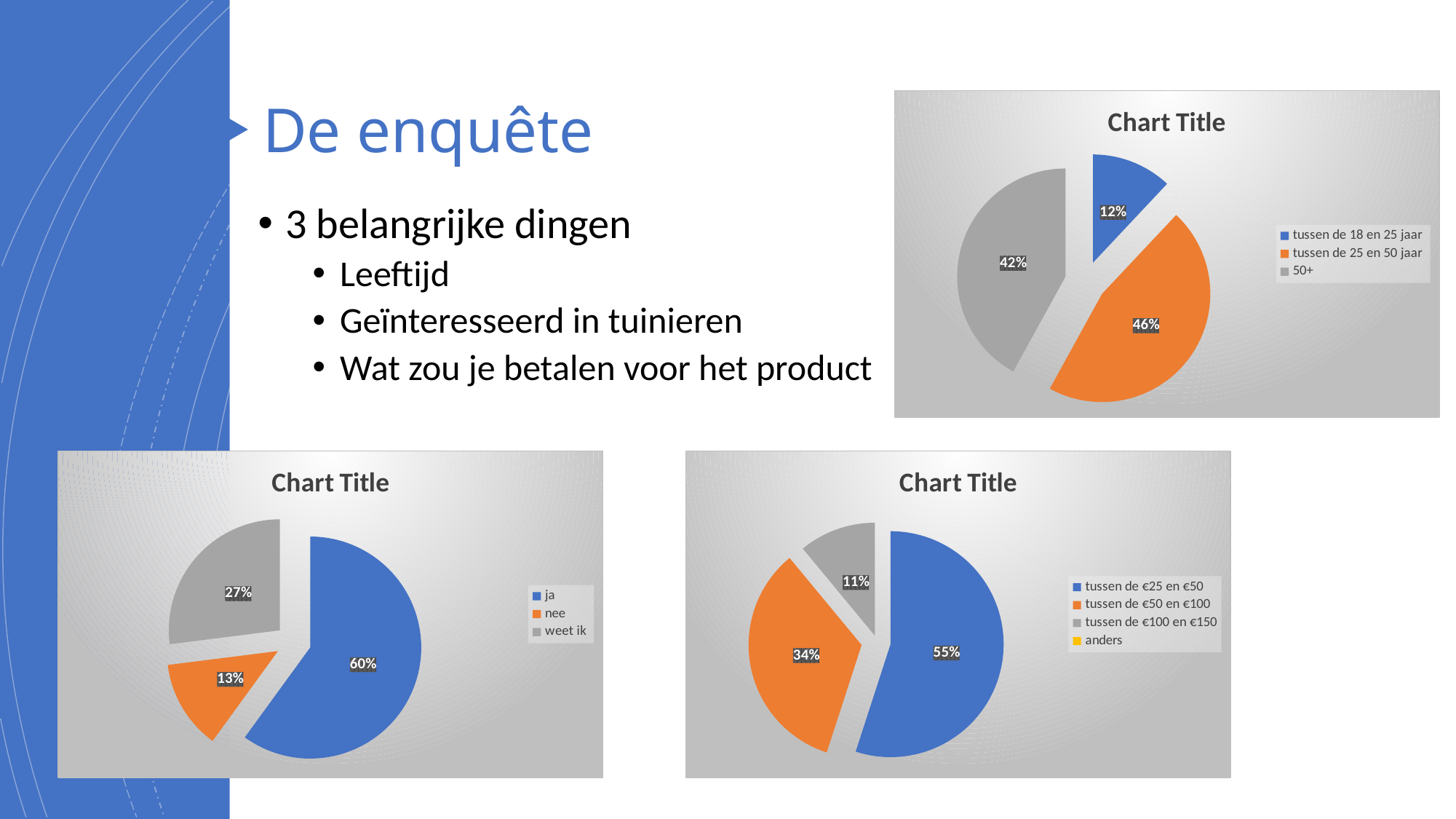
In the bottom-left pie chart, what share is labelled for 'ja'? 60% In the top-right pie chart, what is the difference between the '50+' slice and the 'tussen de 18 en 25 jaar' slice? 30% What type of chart is the bottom-left chart? pie chart In the bottom-left pie chart, which category has the largest slice? ja In the top-right pie chart, how many legend entries are listed? 3 In the bottom-left pie chart, what is the difference between the 'weet ik' slice and the 'nee' slice? 14% In the bottom-right pie chart, how many entries does the legend list? 4 In the bottom-right pie chart, what share is labelled for 'tussen de €50 en €100'? 34% In the bottom-right pie chart, which category has the largest slice? tussen de €25 en €50 In the bottom-left pie chart, which is larger: 'nee' or 'weet ik'? weet ik In the top-right pie chart, which category has the smallest slice? tussen de 18 en 25 jaar In the top-right pie chart, what share is labelled for 'tussen de 25 en 50 jaar'? 46%